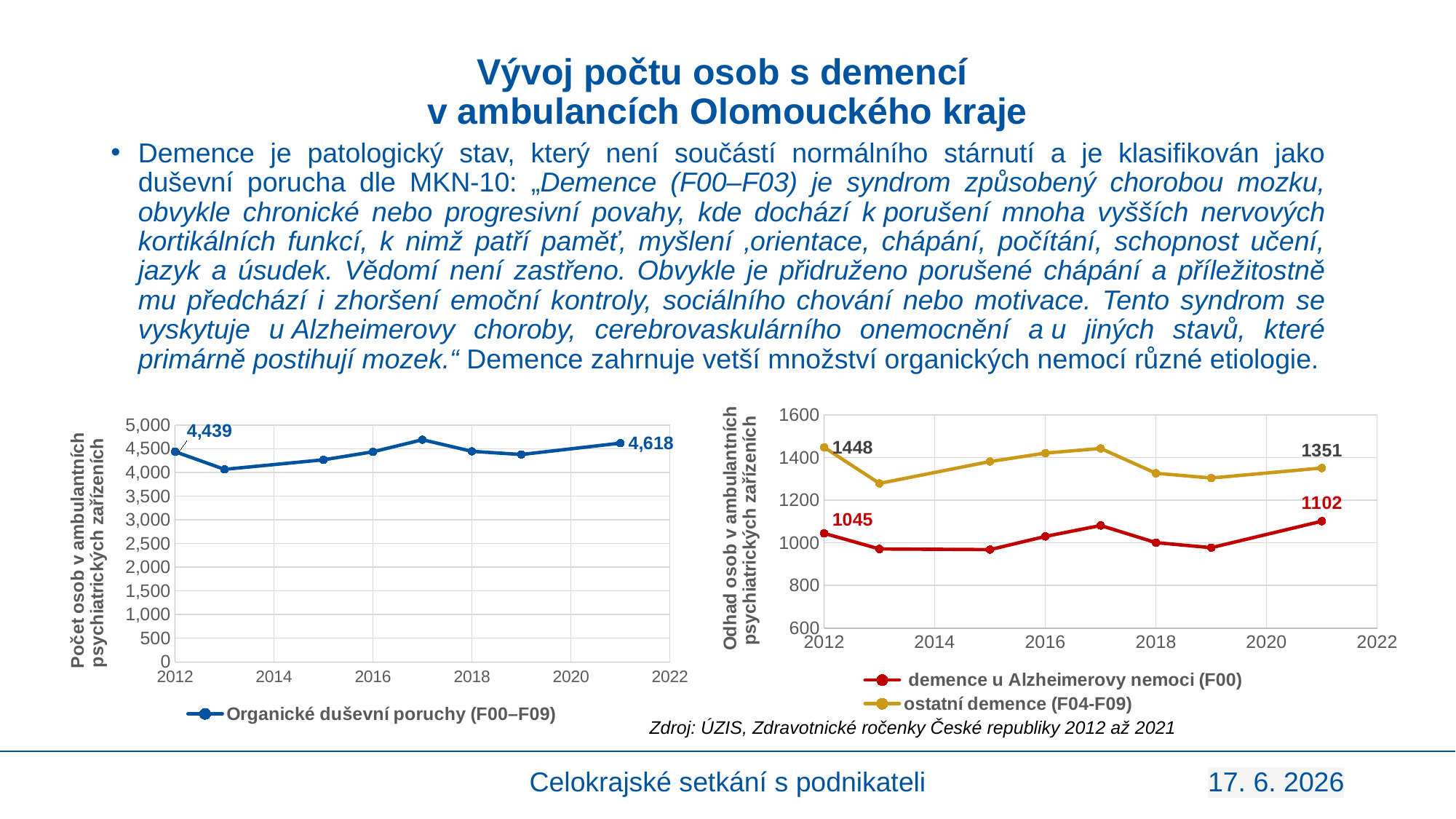
In the left chart, what is the value for Organické duševní poruchy (F00–F09) in 2012? 4,439 In the left chart, by how much did the value for Organické duševní poruchy (F00–F09) change from 2012 to 2021? 179 In the right chart, what is the difference between the 2012 and 2021 values for ostatní demence (F04-F09)? 97 In the right chart, is the value for ostatní demence (F04-F09) in 2013 greater or less than 1400? less In the right chart, which series has the higher value in 2021? ostatní demence (F04-F09) What kind of chart is the left chart? line chart How many data points are plotted in the left chart? 8 In the left chart, what is the value for Organické duševní poruchy (F00–F09) in 2021? 4,618 In the right chart, what is the value for ostatní demence (F04-F09) in 2021? 1351 How many series does the legend of the right chart list? 2 In the right chart, what is the value for demence u Alzheimerovy nemoci (F00) in 2012? 1045 In the left chart, which year has the lowest value? 2013